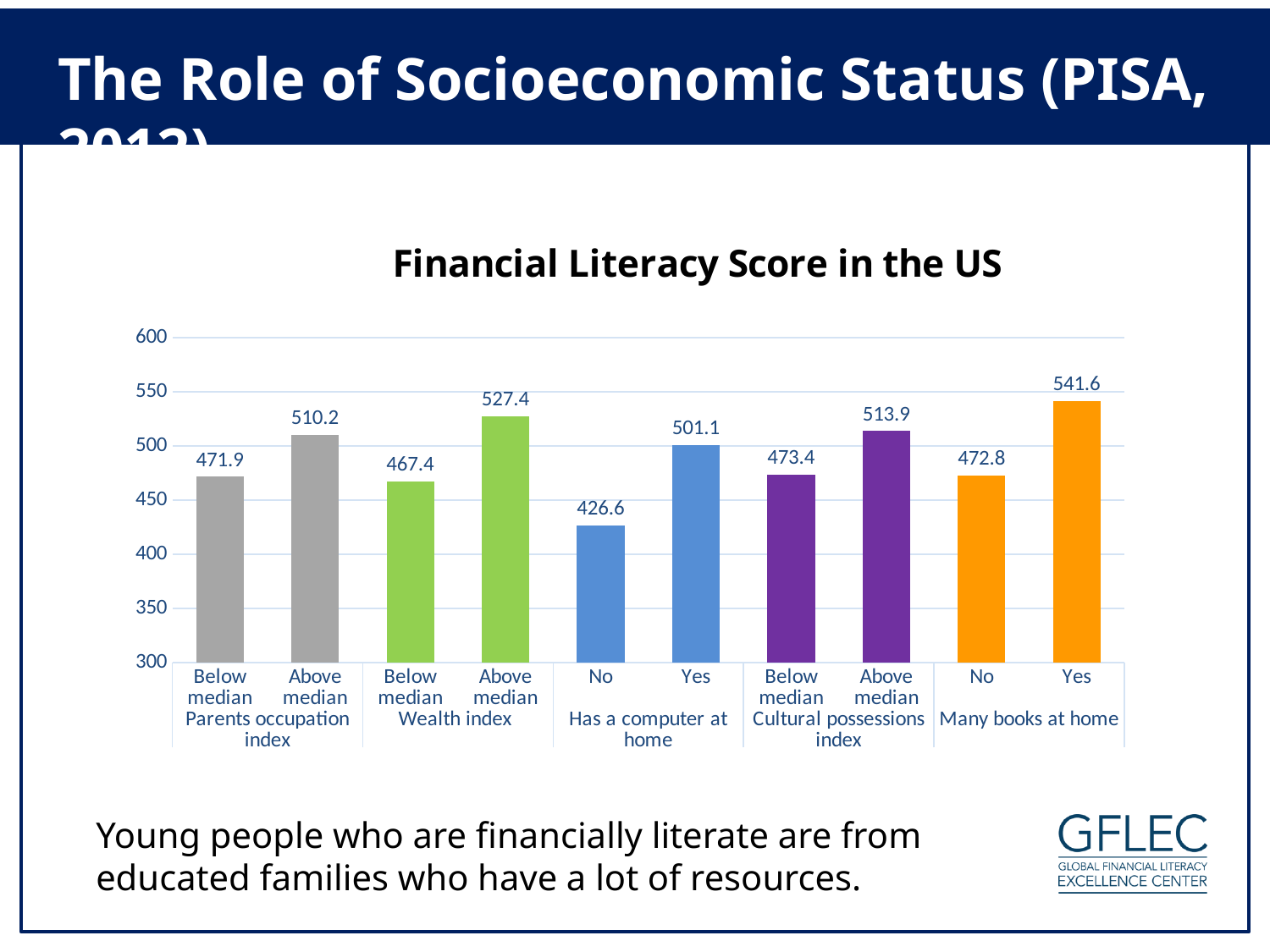
What is the difference in score between students with and without a computer at home? 74.5 Which category has the lowest financial literacy score? Has a computer at home – No How many bars are plotted in the chart? 10 What is the financial literacy score for students above the median on the Parents occupation index? 510.2 Which is larger: the score for above median on the Cultural possessions index or above median on the Parents occupation index? Above median on the Cultural possessions index What is the financial literacy score for students with many books at home (Yes)? 541.6 What is the financial literacy score for students who do not have a computer at home? 426.6 What is the difference in score between students above and below the median on the Wealth index? 60.0 What is the title of the chart? Financial Literacy Score in the US What type of chart is shown on the slide? Bar chart What is the financial literacy score for students below the median on the Wealth index? 467.4 Which category has the highest financial literacy score? Many books at home – Yes